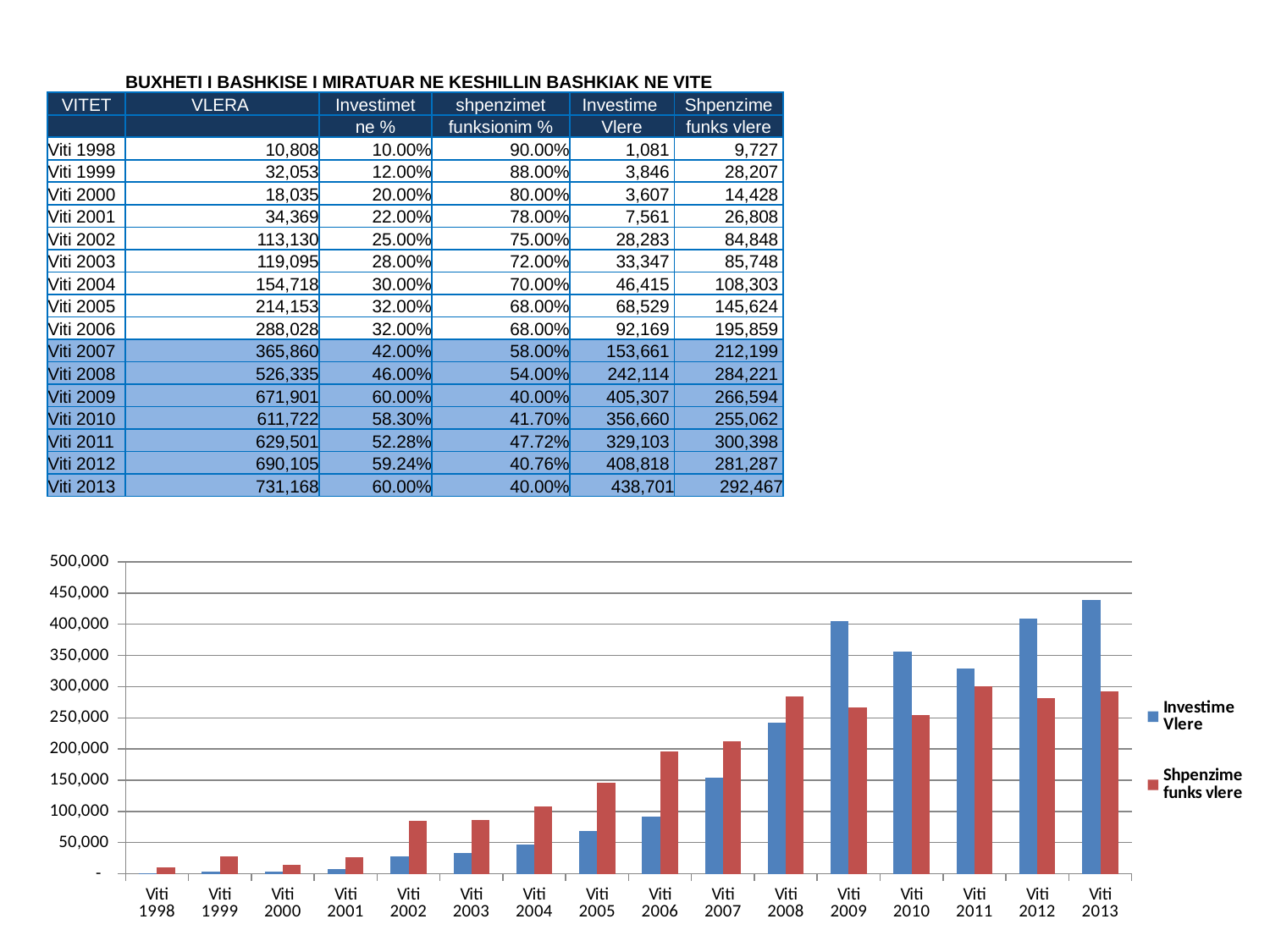
Is the Shpenzime funks vlere value for Viti 2006 greater or less than 150,000? greater Which year has the highest Investime Vlere bar in the chart? Viti 2013 For Viti 2009, which is larger: Investime Vlere or Shpenzime funks vlere? Investime Vlere What kind of chart is shown at the bottom of the slide? bar chart How many series does the chart's legend list? 2 Do the Investime Vlere bars generally rise or fall from Viti 1998 to Viti 2009? rise How many years (categories) are plotted along the x axis of the chart? 16 Which year has the lowest Investime Vlere bar in the chart? Viti 1998 Is the Investime Vlere value for Viti 2008 greater or less than 200,000? greater According to the table, what is the Investime Vlere value for Viti 2013? 438,701 Using the values in the table, what is the difference between Investime Vlere and Shpenzime funks vlere for Viti 2013? 146,234 For Viti 2008, which is larger: Investime Vlere or Shpenzime funks vlere? Shpenzime funks vlere